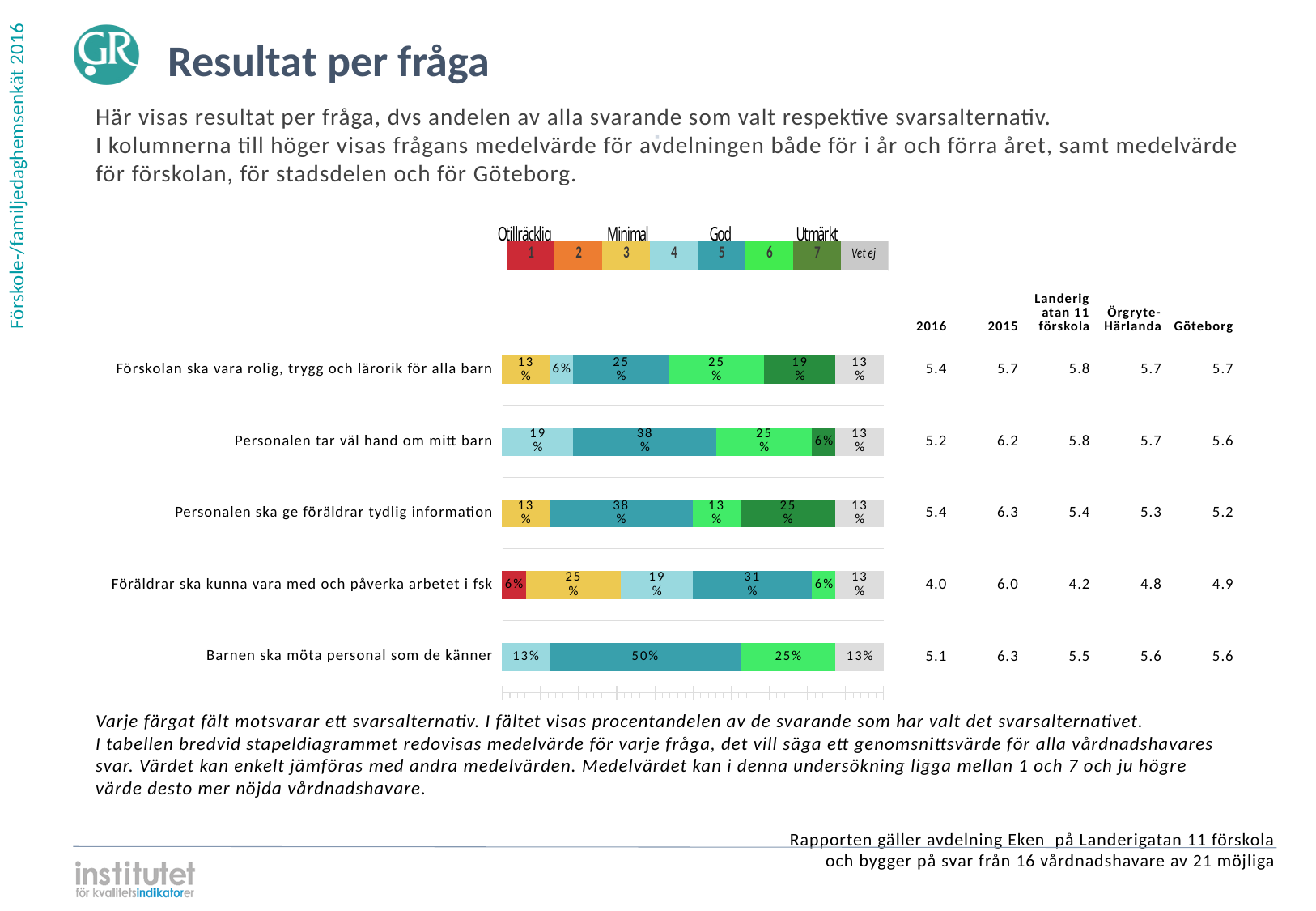
Which question has the largest single segment in its bar? Barnen ska möta personal som de känner What percentage of respondents chose option 7 for 'Förskolan ska vara rolig, trygg och lärorik för alla barn'? 19% Which question is the only one with a segment for option 1 (Otillräcklig)? Föräldrar ska kunna vara med och påverka arbetet i fsk What label does the legend give to options 5 in the chart? God How many questions (categories) are plotted in the bar chart? 5 What percentage of respondents chose option 1 for 'Föräldrar ska kunna vara med och påverka arbetet i fsk'? 6% What percentage of respondents chose option 5 for 'Barnen ska möta personal som de känner'? 50% What is the difference between the option 5 share and the option 6 share for 'Personalen tar väl hand om mitt barn'? 13% What percentage of respondents answered 'Vet ej' for 'Personalen tar väl hand om mitt barn'? 13% How many response options does the legend above the chart list? 8 What kind of chart is shown on the slide? Stacked bar chart For 'Personalen ska ge föräldrar tydlig information', which is larger: the share for option 5 or the share for option 7? Option 5